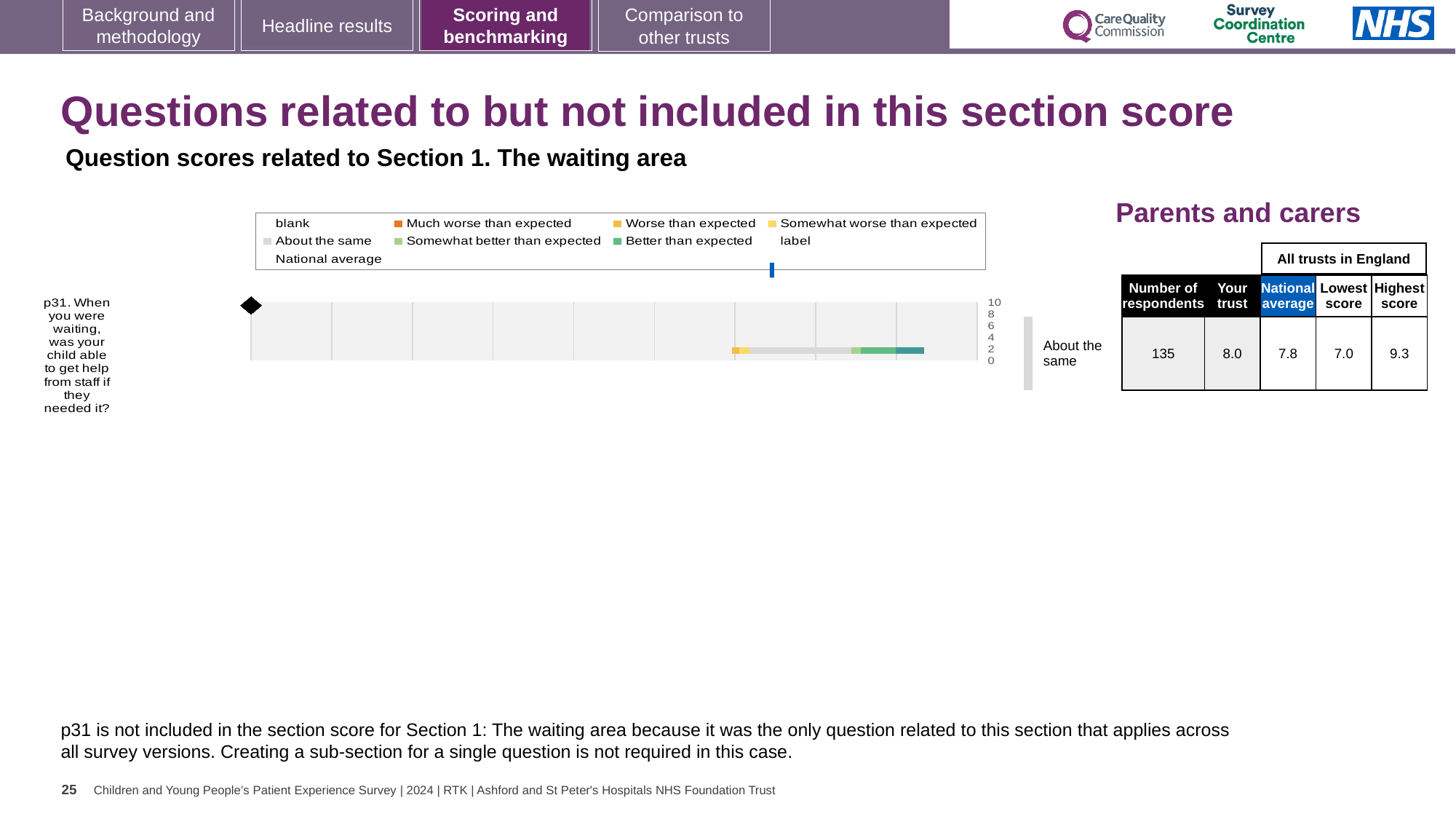
What is the difference between the Highest score and the Lowest score for p31? 2.3 How many survey questions are plotted in the chart? 1 What is the Lowest score among all trusts in England for p31? 7.0 Which is higher for p31: the 'Your trust' score or the National average? Your trust What benchmark category label is shown to the right of the p31 bar? About the same Which question number is plotted in the chart? p31 What kind of chart is shown for question p31? bar chart How many respondents answered p31? 135 What is the 'Your trust' score for p31 in the Parents and carers table? 8.0 By how much does the 'Your trust' score for p31 exceed the National average? 0.2 What is the Highest score among all trusts in England for p31? 9.3 What is the National average score for p31? 7.8